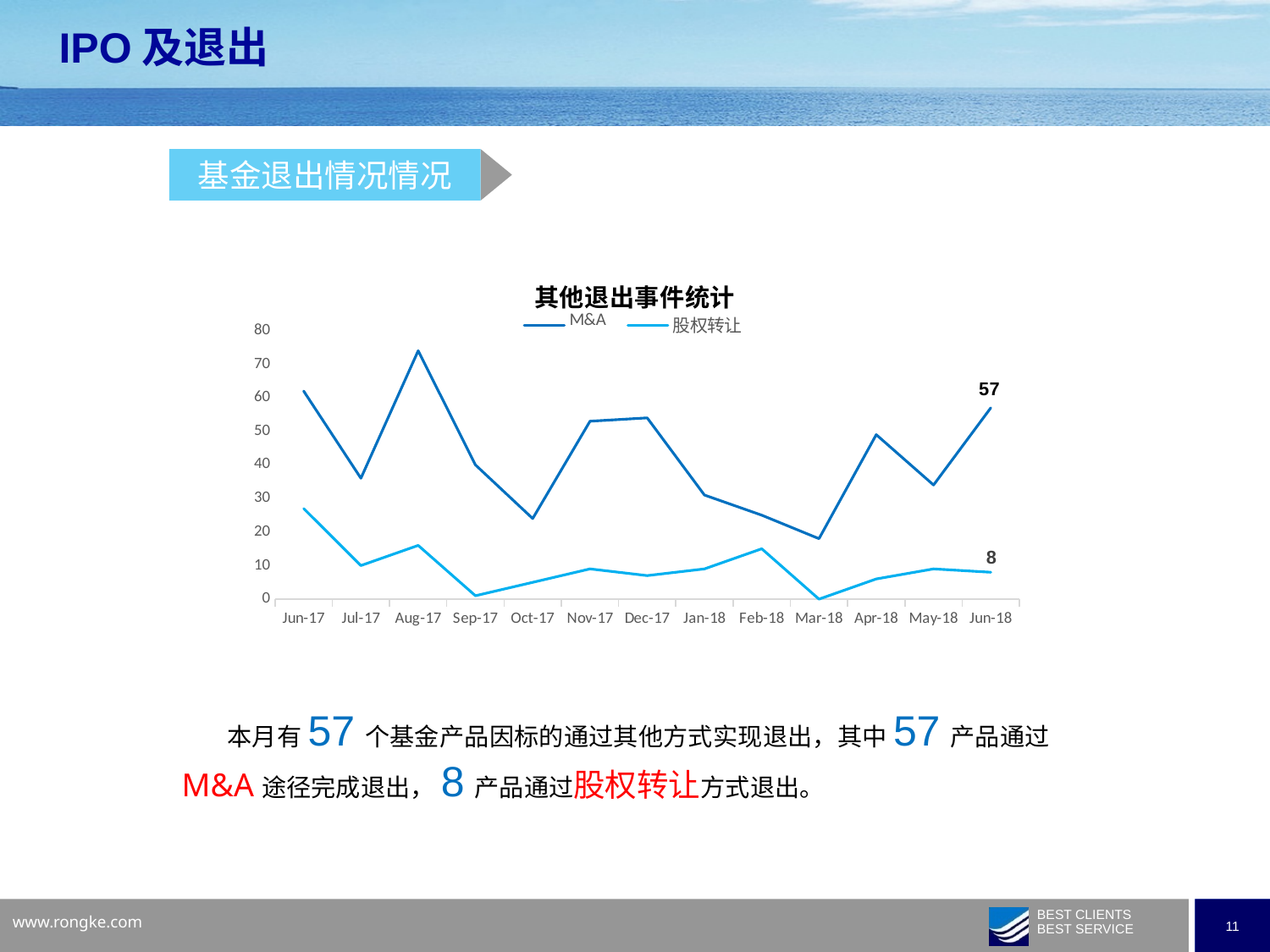
How many months are shown on the x axis of the chart? 13 How many series does the legend list? 2 What is the value of the 股权转让 series for Jun-18? 8 In which month does the 股权转让 series reach its highest value? Jun-17 What is the value of the M&A series for Jun-18? 57 What kind of chart is shown on the slide? Line chart What is the difference between the M&A value and the 股权转让 value for Jun-18? 49 In which month does the M&A series reach its highest value? Aug-17 In which month does the M&A series reach its lowest value? Mar-18 Is the M&A value for Jul-17 greater or less than 40? less Which series has the larger value for Jun-18, M&A or 股权转让? M&A Is the M&A value for Aug-17 greater or less than 70? greater